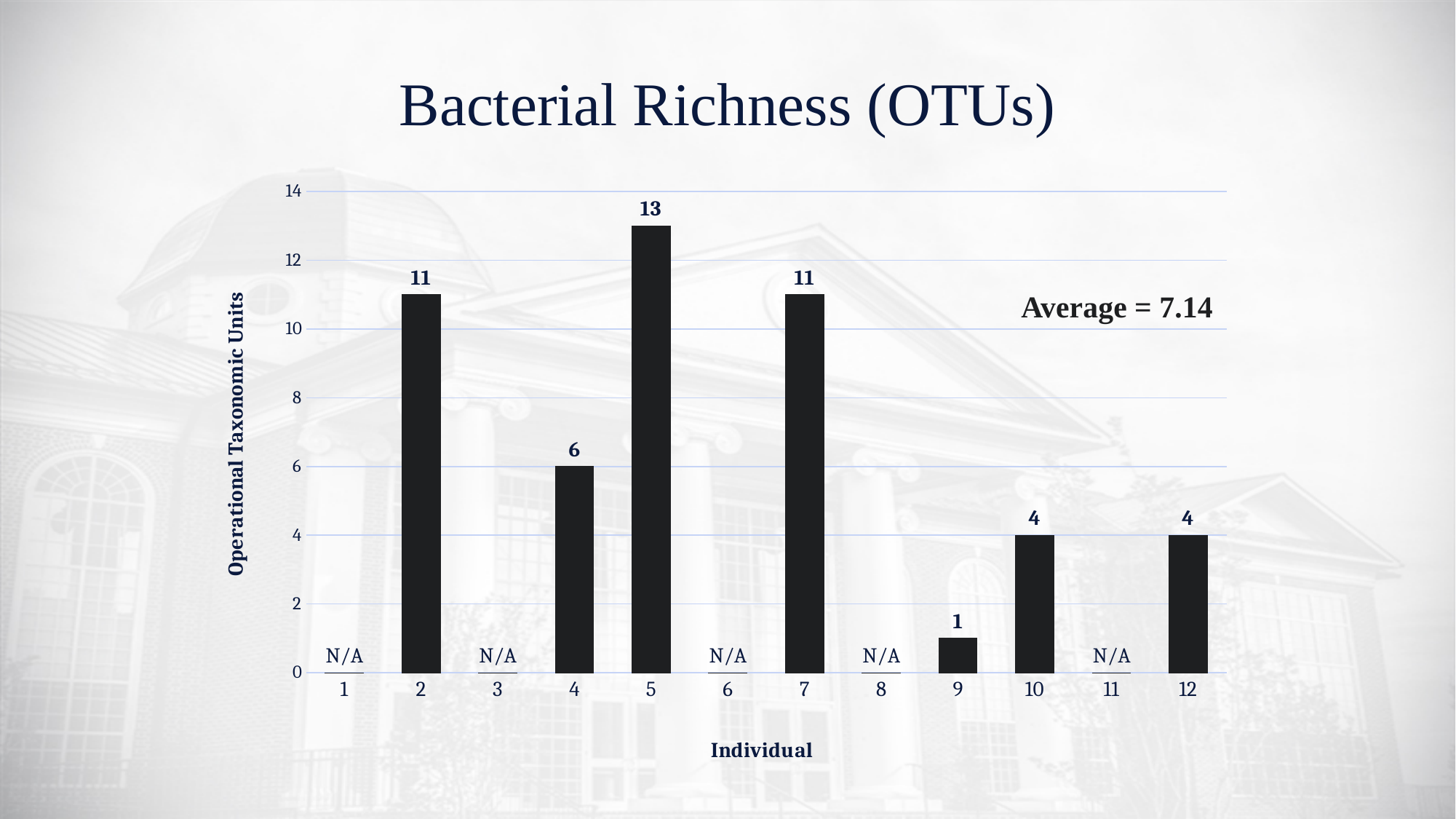
How many individuals are labelled on the x axis? 12 Which individual has the highest number of Operational Taxonomic Units? 5 What is the value for Individual 9? 1 What is the difference between the values for Individual 5 and Individual 2? 2 What is the title of the chart? Bacterial Richness (OTUs) Which is larger, the value for Individual 7 or the value for Individual 10? Individual 7 What is the value for Individual 4? 6 How many individuals are marked N/A? 5 Among the individuals with a plotted value, which has the lowest number of Operational Taxonomic Units? 9 What is the value for Individual 5? 13 What average value is stated on the chart? 7.14 What kind of chart is shown on the slide? Bar chart